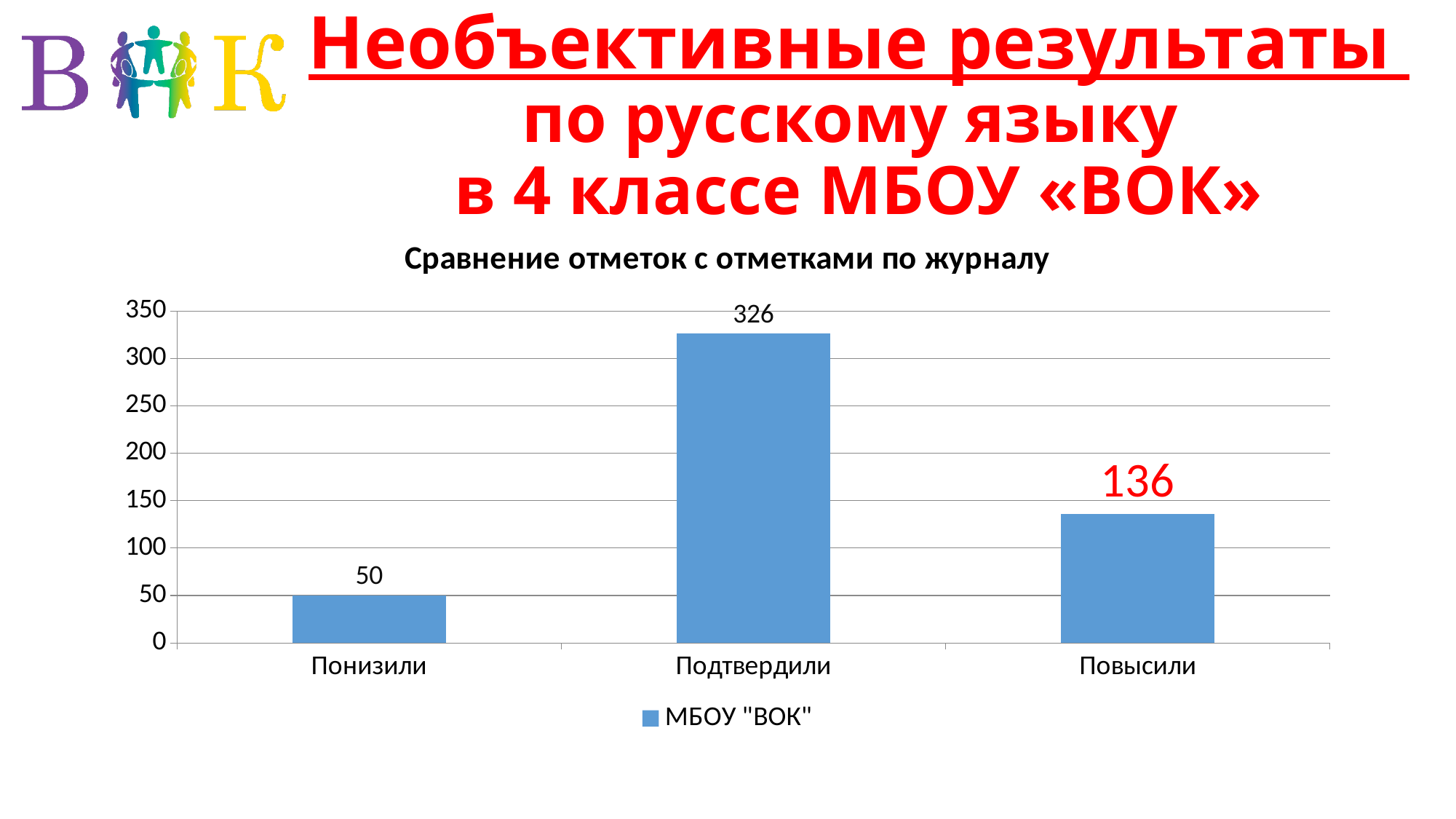
What is the value for Подтвердили? 326 How many categories are shown on the x axis? 3 What is the title of the chart? Сравнение отметок с отметками по журналу What is the value for Повысили? 136 What is the value for Понизили? 50 Is the value for Подтвердили greater or less than 300? greater What is the difference between the values for Повысили and Понизили? 86 What is the difference between the values for Подтвердили and Повысили? 190 Which category has the lowest value? Понизили What kind of chart is shown on the slide? bar chart Which is larger, the value for Повысили or the value for Понизили? Повысили Which category has the highest value? Подтвердили